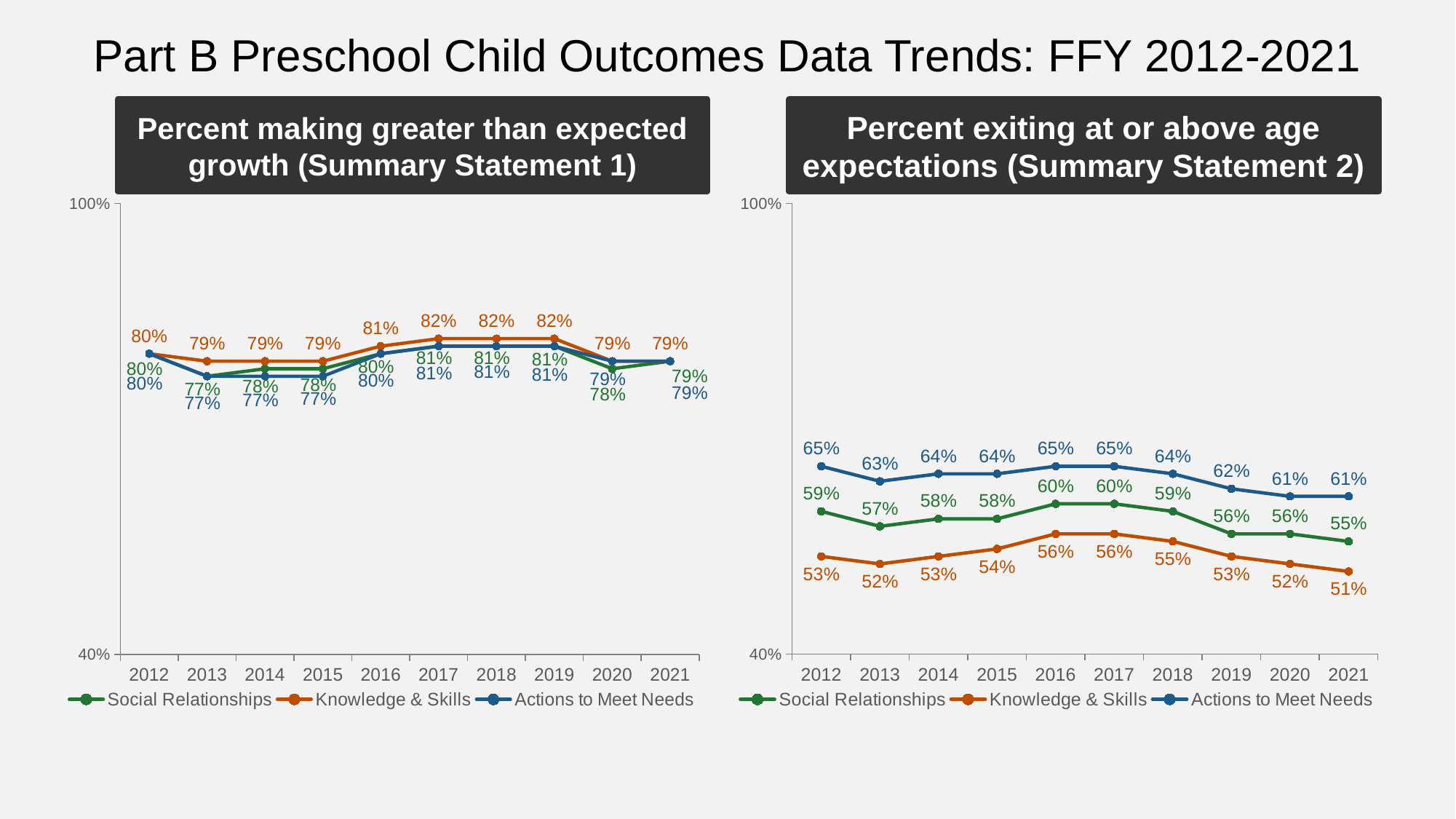
How many series does the legend of the 'Percent exiting at or above age expectations (Summary Statement 2)' chart list? 3 What colour is the Knowledge & Skills line on the 'Percent making greater than expected growth (Summary Statement 1)' chart? Orange On the 'Percent making greater than expected growth (Summary Statement 1)' chart, what is the value for Knowledge & Skills in 2017? 82% On the 'Percent exiting at or above age expectations (Summary Statement 2)' chart, which series is higher in 2019: Social Relationships or Knowledge & Skills? Social Relationships On the 'Percent exiting at or above age expectations (Summary Statement 2)' chart, what is the value for Knowledge & Skills in 2021? 51% On the 'Percent exiting at or above age expectations (Summary Statement 2)' chart, what is the difference between Actions to Meet Needs and Knowledge & Skills in 2016? 9% What kind of chart is the 'Percent exiting at or above age expectations (Summary Statement 2)' chart? Line chart On the 'Percent exiting at or above age expectations (Summary Statement 2)' chart, in which year is Social Relationships lowest? 2021 On the 'Percent exiting at or above age expectations (Summary Statement 2)' chart, what is the value for Actions to Meet Needs in 2012? 65% How many years are shown on the x axis of the 'Percent making greater than expected growth (Summary Statement 1)' chart? 10 On the 'Percent making greater than expected growth (Summary Statement 1)' chart, what is the difference between Knowledge & Skills and Actions to Meet Needs in 2013? 2% On the 'Percent exiting at or above age expectations (Summary Statement 2)' chart, does Actions to Meet Needs rise or fall from 2017 to 2021? Fall